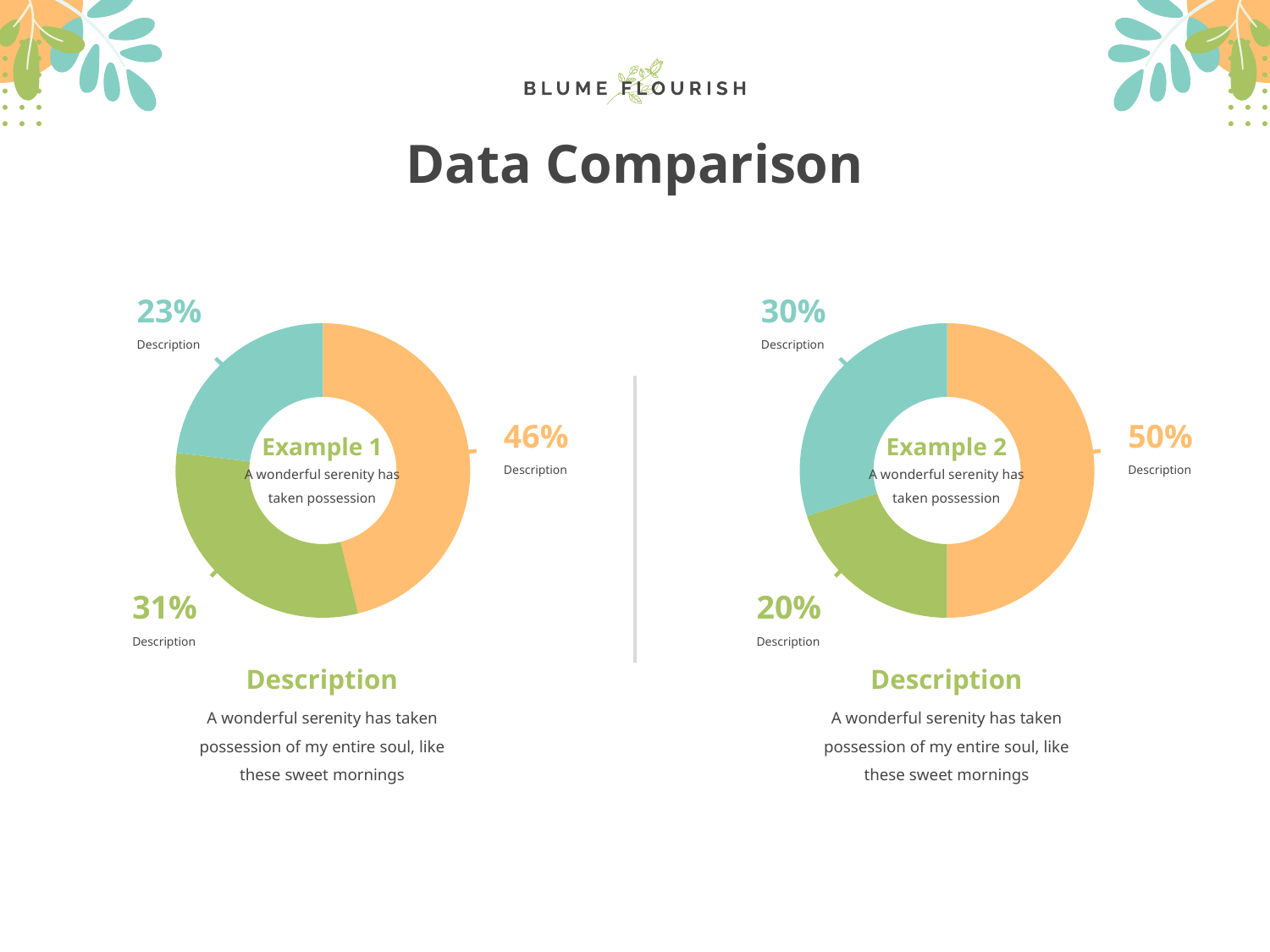
What is the title of the slide? Data Comparison In the Example 2 chart, what is the difference between the teal segment and the green segment? 10% In the Example 1 chart, what percentage does the orange segment represent? 46% In the Example 2 chart, what percentage does the green segment represent? 20% In the Example 1 chart, what is the difference between the orange segment and the green segment? 15% What type of chart is used for Example 2? Donut chart In the Example 1 chart, what percentage does the teal segment represent? 23% In the Example 2 chart, which colour segment has the smallest share? Green In the Example 1 chart, which colour segment has the largest share? Orange In the Example 2 chart, what percentage does the orange segment represent? 50% How many segments does the Example 1 chart have? 3 Which is larger: the teal segment in the Example 1 chart or the teal segment in the Example 2 chart? Example 2